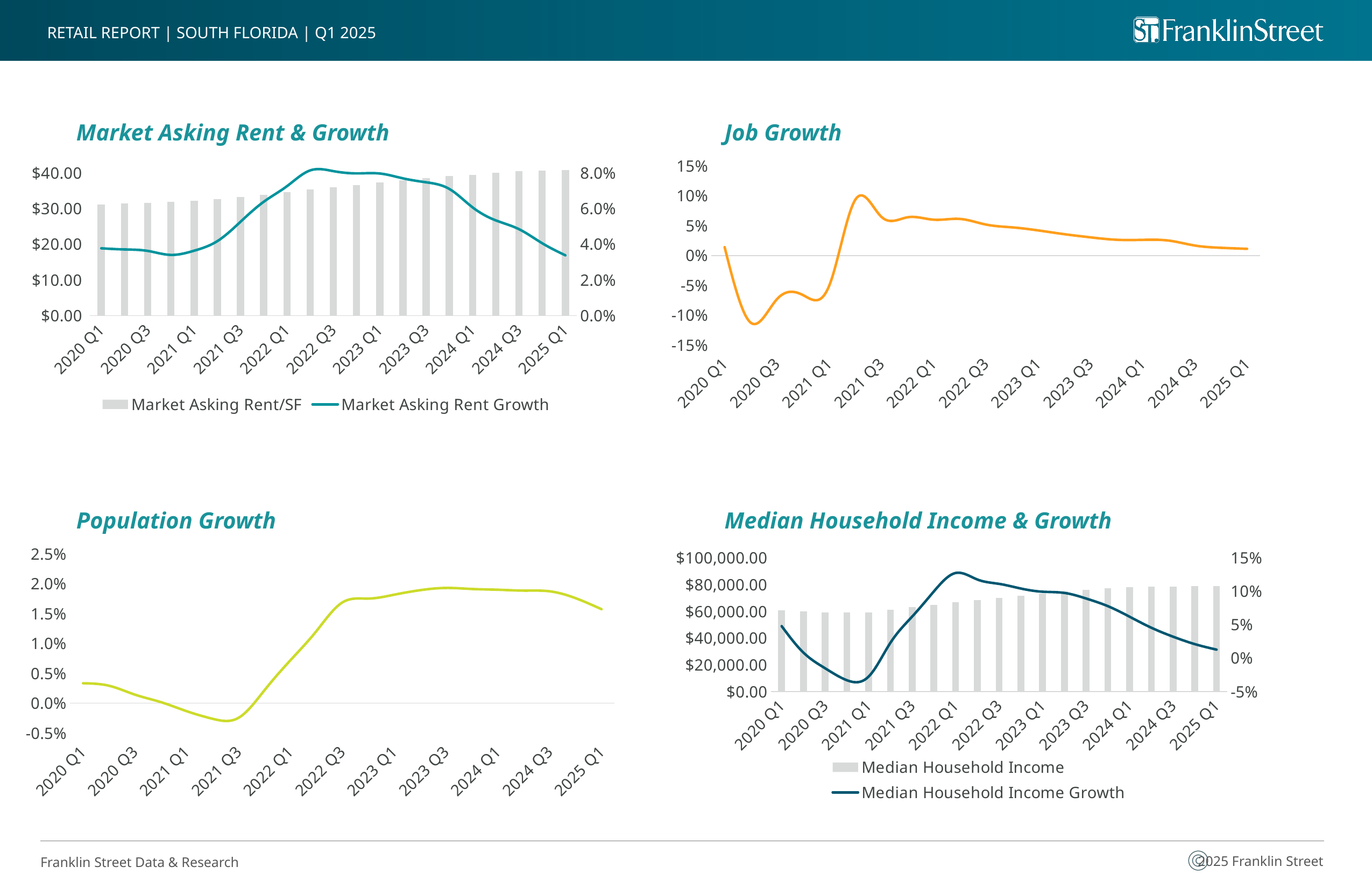
In the Population Growth chart, is the value for 2021 Q3 greater or less than 0.0%? less In the Median Household Income & Growth chart, what colour is the Median Household Income Growth line? dark blue In the Market Asking Rent & Growth chart, do the Market Asking Rent/SF bars rise or fall from 2020 Q1 to 2025 Q1? rise What kind of chart is the Job Growth chart? line chart In the Population Growth chart, is the value for 2025 Q1 greater or less than 1.0%? greater In the Median Household Income & Growth chart, is the Median Household Income bar for 2025 Q1 greater or less than $60,000.00? greater In the Market Asking Rent & Growth chart, how many series does the legend list? 2 In the Job Growth chart, does the line rise or fall from 2021 Q3 to 2025 Q1? fall